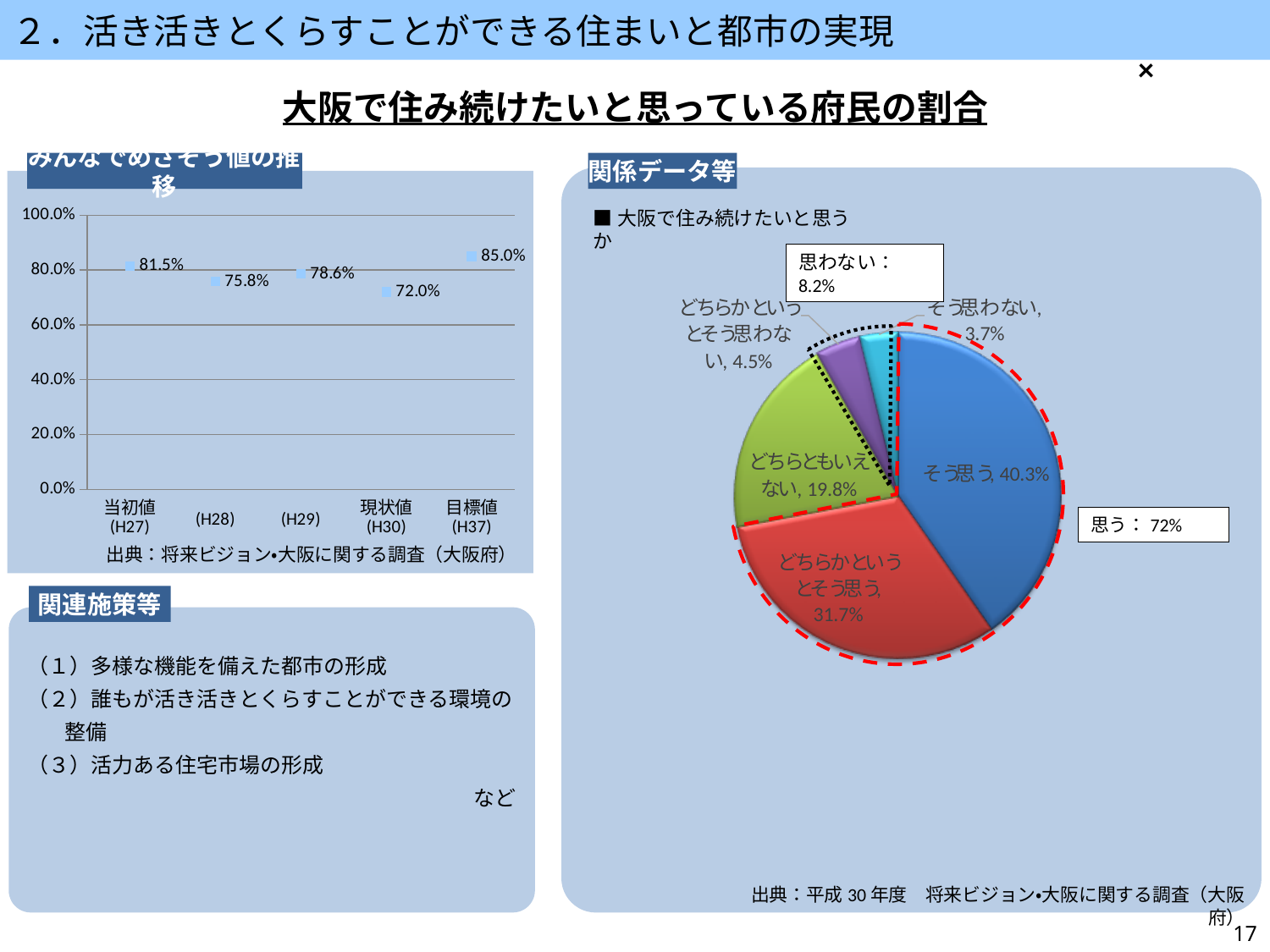
In the left chart (みんなでめざそう値の推移), how many data points are plotted? 5 What kind of chart is shown on the right side of the slide under 関係データ等? pie chart In the pie chart on the right (大阪で住み続けたいと思うか), which slice is the smallest? そう思わない In the left chart (みんなでめざそう値の推移), what is the value for 当初値 (H27)? 81.5% In the left chart (みんなでめざそう値の推移), what is the value for 目標値 (H37)? 85.0% In the pie chart on the right (大阪で住み続けたいと思うか), what is the combined share of そう思う and どちらかというとそう思う? 72% In the left chart (みんなでめざそう値の推移), which point has the lowest value? 現状値 (H30) In the left chart (みんなでめざそう値の推移), what is the difference between the value for H29 and the value for H28? 2.8% In the left chart (みんなでめざそう値の推移), is the value for H28 greater or less than 80.0%? less In the left chart (みんなでめざそう値の推移), what is the value for 現状値 (H30)? 72.0% In the pie chart on the right (大阪で住み続けたいと思うか), what share is どちらともいえない? 19.8% In the pie chart on the right (大阪で住み続けたいと思うか), what share is そう思う? 40.3%